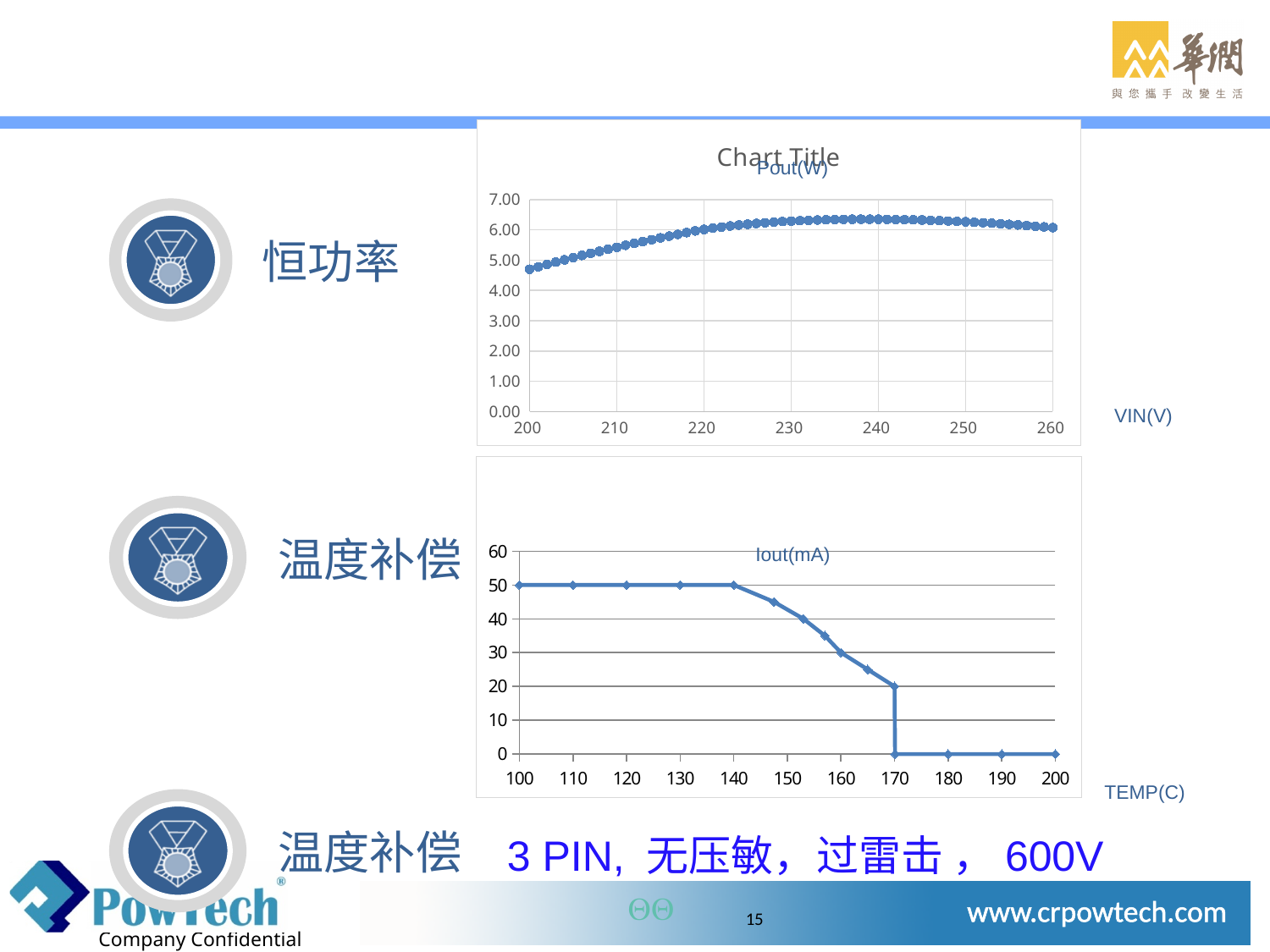
In the bottom chart, which has the larger Iout(mA) value: TEMP 140 C or TEMP 160 C? 140 C In the top chart, is the Pout(W) value at VIN 240 V greater or less than 6.00? greater What kind of chart is the bottom chart titled 'Iout(mA)'? line chart In the bottom chart, what is the lowest Iout(mA) value plotted? 0 In the bottom chart, what is the highest Iout(mA) value plotted? 50 In the bottom chart, what is the Iout(mA) value at TEMP 190 C? 0 In the top chart, does Pout(W) rise or fall as VIN increases from 200 V to 220 V? rise What is the label of the horizontal axis of the bottom chart? TEMP(C) In the top chart, is the Pout(W) value at VIN 200 V greater or less than 5.00? less What kind of chart is the top chart titled 'Chart Title'? line chart In the bottom chart, what is the Iout(mA) value at TEMP 120 C? 50 In the bottom chart, is the Iout(mA) value at TEMP 150 C greater or less than 50? less